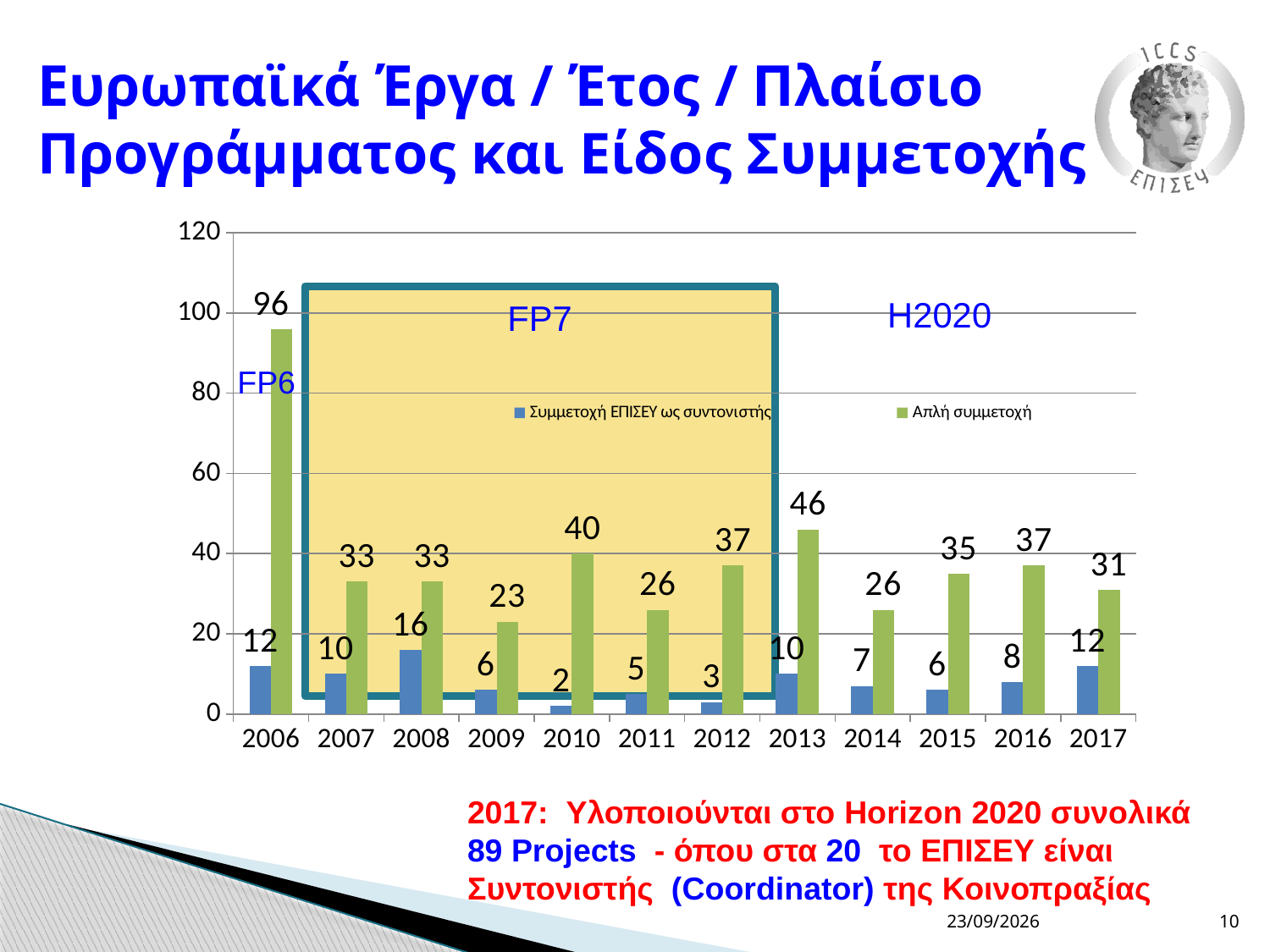
What is the total of the two series for 2017? 43 What is the value of Απλή συμμετοχή for 2013? 46 What kind of chart is shown on the slide? Bar chart How many series does the legend list? 2 What is the difference between the Απλή συμμετοχή values for 2013 and 2014? 20 Which year has the highest value for Απλή συμμετοχή? 2006 How many years are shown on the x axis? 12 What is the value of Απλή συμμετοχή for 2006? 96 Which year has the lowest value for Συμμετοχή ΕΠΙΣΕΥ ως συντονιστής? 2010 Which framework programme label is shown inside the highlighted box covering 2007 to 2012? FP7 Which is larger: the Απλή συμμετοχή value for 2010 or for 2017? 2010 What is the value of Συμμετοχή ΕΠΙΣΕΥ ως συντονιστής for 2008? 16